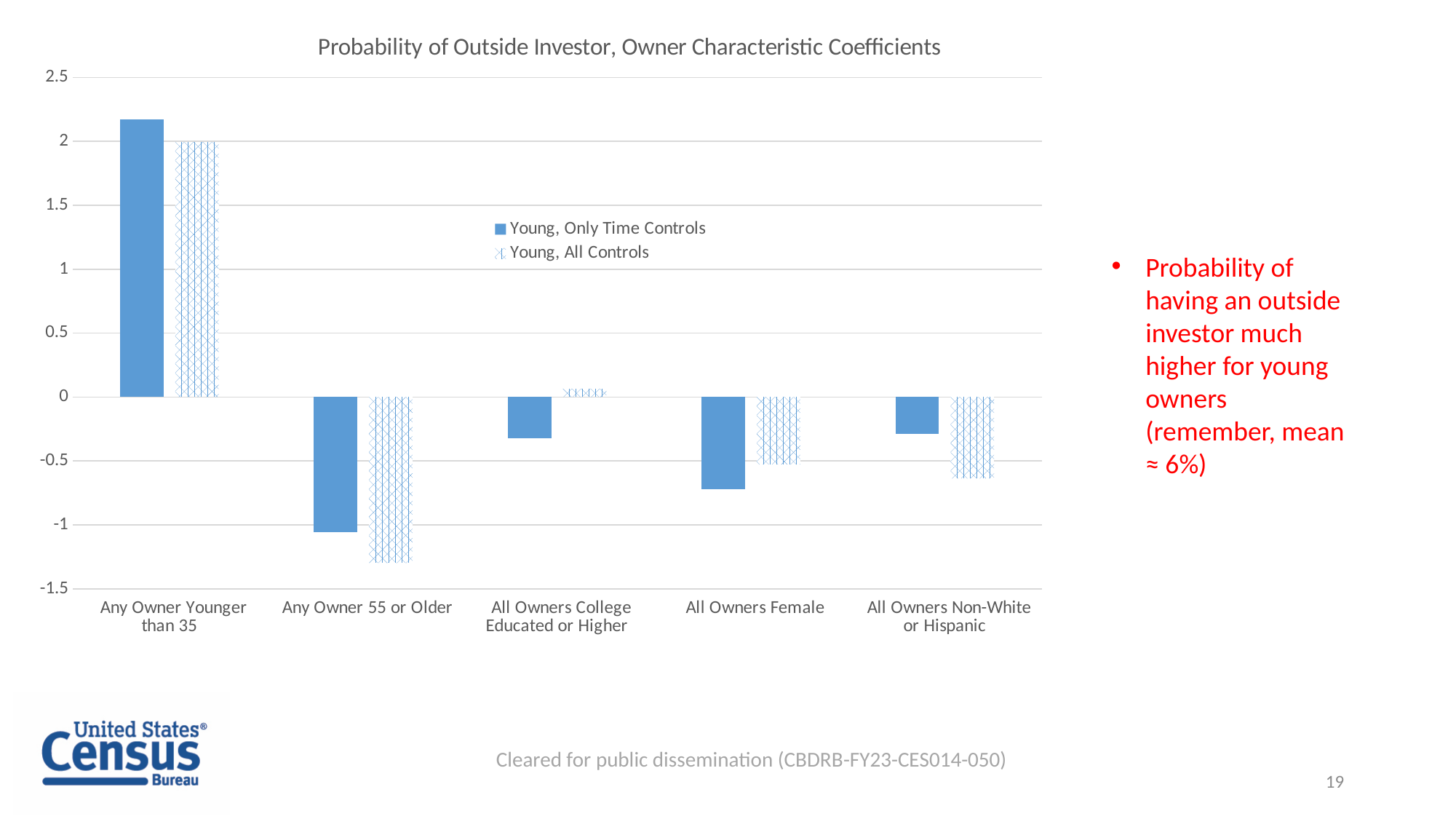
Which category has the highest value for the 'Young, Only Time Controls' series? Any Owner Younger than 35 How many series does the chart's legend list? 2 Which category has the lowest value for the 'Young, All Controls' series? Any Owner 55 or Older What is the title of the chart? Probability of Outside Investor, Owner Characteristic Coefficients Is the 'Young, Only Time Controls' value for 'All Owners College Educated or Higher' greater or less than -0.5? greater What kind of chart is shown on the slide? Bar chart How many owner characteristic categories are shown on the x axis? 5 Is the 'Young, All Controls' value for 'Any Owner 55 or Older' greater or less than -1? less For the 'Young, Only Time Controls' series, which is larger: the value for 'All Owners Female' or the value for 'All Owners Non-White or Hispanic'? All Owners Non-White or Hispanic For 'Any Owner 55 or Older', which series has the larger value: 'Young, Only Time Controls' or 'Young, All Controls'? Young, Only Time Controls Is the 'Young, Only Time Controls' value for 'All Owners Female' greater or less than -0.5? less